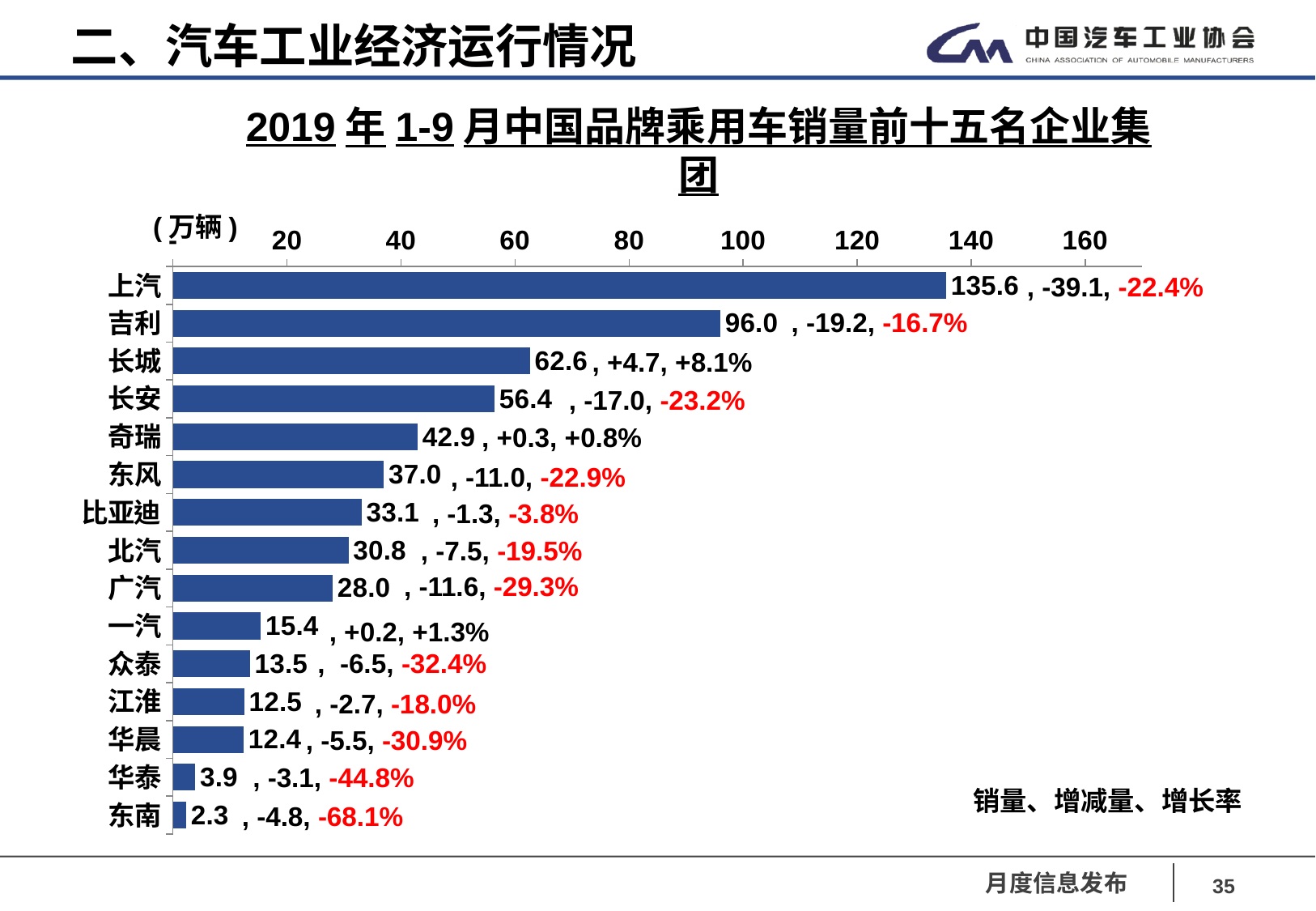
What growth rate is shown for 东南? -68.1% What type of chart is shown on the slide? bar chart Which company has the lowest sales in the chart? 东南 What is the difference in sales between 上汽 and 吉利? 39.6 What is the change in sales (增减量) shown for 东风? -11.0 Which has higher sales, 长安 or 奇瑞? 长安 What is the sales value (万辆) shown for 上汽? 135.6 Is the sales value for 吉利 greater or less than 100? less Which company has the highest sales in the chart? 上汽 What growth rate is shown for 长城? +8.1% What unit is shown for the sales axis of the chart? 万辆 How many companies are shown in the chart? 15